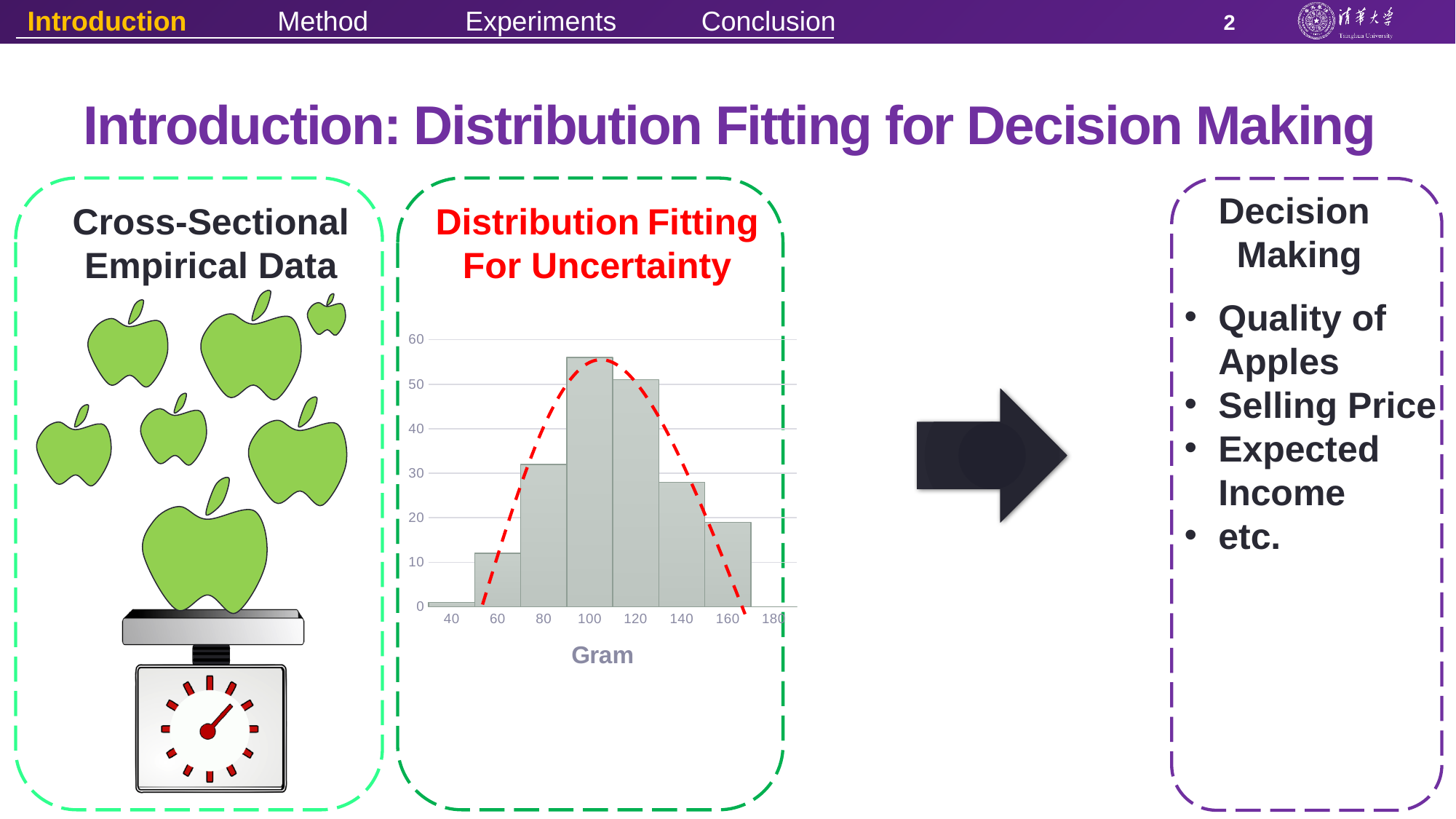
Is the value of the bar between 150 and 170 grams greater or less than 30? less Is the value of the tallest bar (around 100 grams) greater or less than 50? greater Which bar is taller: the one between 70 and 90 grams or the one between 150 and 170 grams? the one between 70 and 90 grams What is the label of the x axis of the chart? Gram Which bar is taller: the one between 110 and 130 grams or the one between 130 and 150 grams? the one between 110 and 130 grams What kind of chart is shown in the 'Distribution Fitting For Uncertainty' box? bar chart Which bin on the x axis has the tallest bar in the chart? 100 (the 90–110 gram bin) Is the value of the bar between 70 and 90 grams greater or less than 40? less What is the highest tick value shown on the y axis of the chart? 60